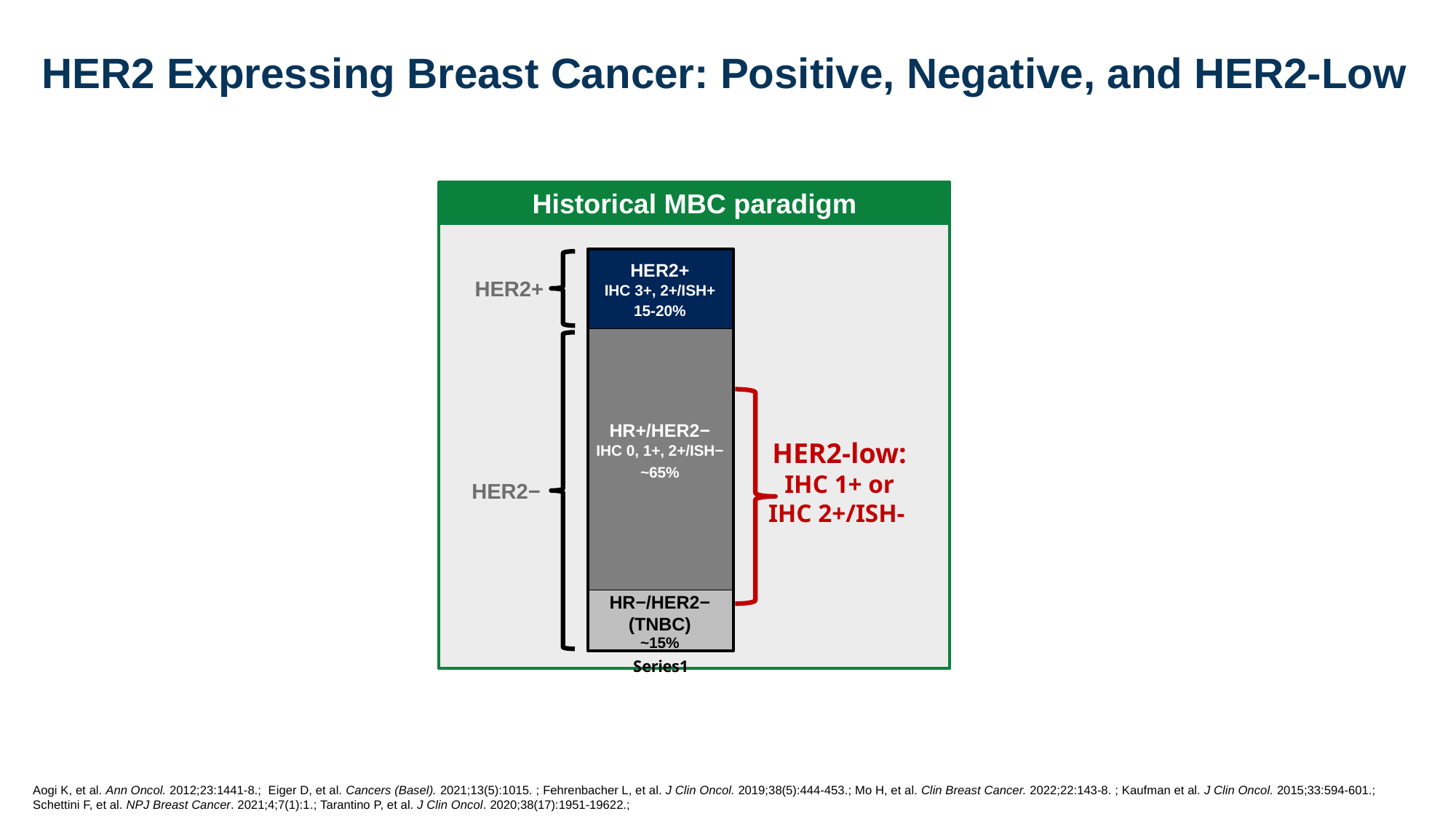
Is the value for the HR+/HER2− segment greater or less than 50%? greater How many segments make up the stacked bar? 3 Is the value for the HR−/HER2− (TNBC) segment greater or less than 50%? less What IHC/ISH criteria are printed on the HER2+ segment? IHC 3+, 2+/ISH+ What is the title shown in the green header above the chart? Historical MBC paradigm What percentage is printed on the HER2+ segment of the bar? 15-20% What percentage is printed on the HR+/HER2− segment of the bar? ~65% What kind of chart is shown under the 'Historical MBC paradigm' heading? Stacked bar chart Which segment is larger, HR+/HER2− or HER2+? HR+/HER2− What definition is given in red text next to the HER2-low bracket? IHC 1+ or IHC 2+/ISH- What percentage is printed on the HR−/HER2− (TNBC) segment of the bar? ~15% Which segment of the stacked bar is the largest? HR+/HER2−